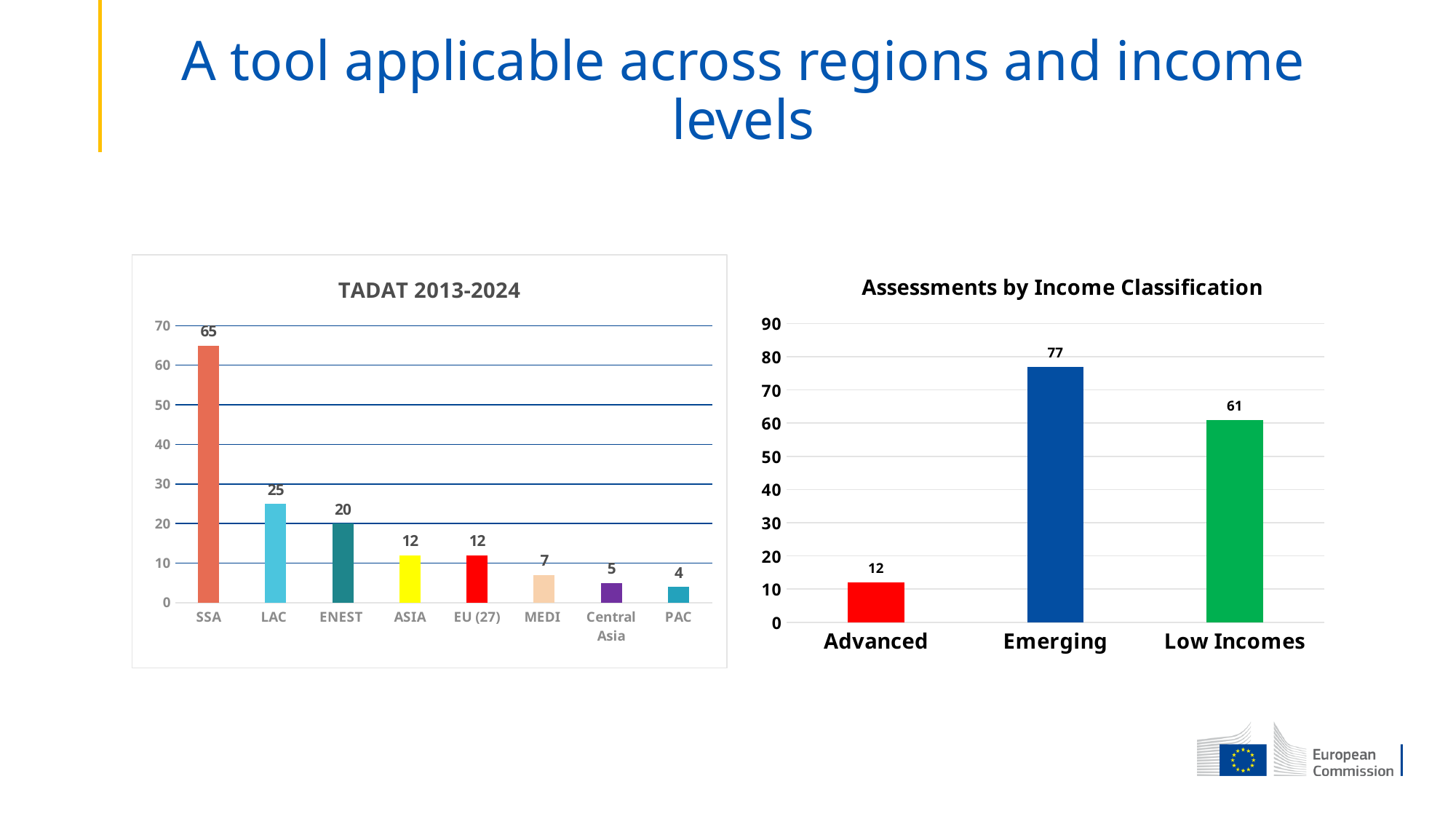
In the 'Assessments by Income Classification' chart, what is the difference between the values for Emerging and Low Incomes? 16 In the 'Assessments by Income Classification' chart, which is larger, the value for Low Incomes or the value for Advanced? Low Incomes In the 'TADAT 2013-2024' chart, is the value for LAC greater or less than 20? greater In the 'TADAT 2013-2024' chart, what is the value for MEDI? 7 In the 'TADAT 2013-2024' chart, what is the value for SSA? 65 In the 'TADAT 2013-2024' chart, which region has the lowest value? PAC In the 'TADAT 2013-2024' chart, which region has the highest value? SSA In the 'Assessments by Income Classification' chart, what is the value for Emerging? 77 In the 'TADAT 2013-2024' chart, how many regions are shown on the x axis? 8 In the 'TADAT 2013-2024' chart, what is the difference between the values for LAC and ENEST? 5 In the 'Assessments by Income Classification' chart, which category has the lowest value? Advanced What kind of chart is the 'Assessments by Income Classification' chart? Bar chart